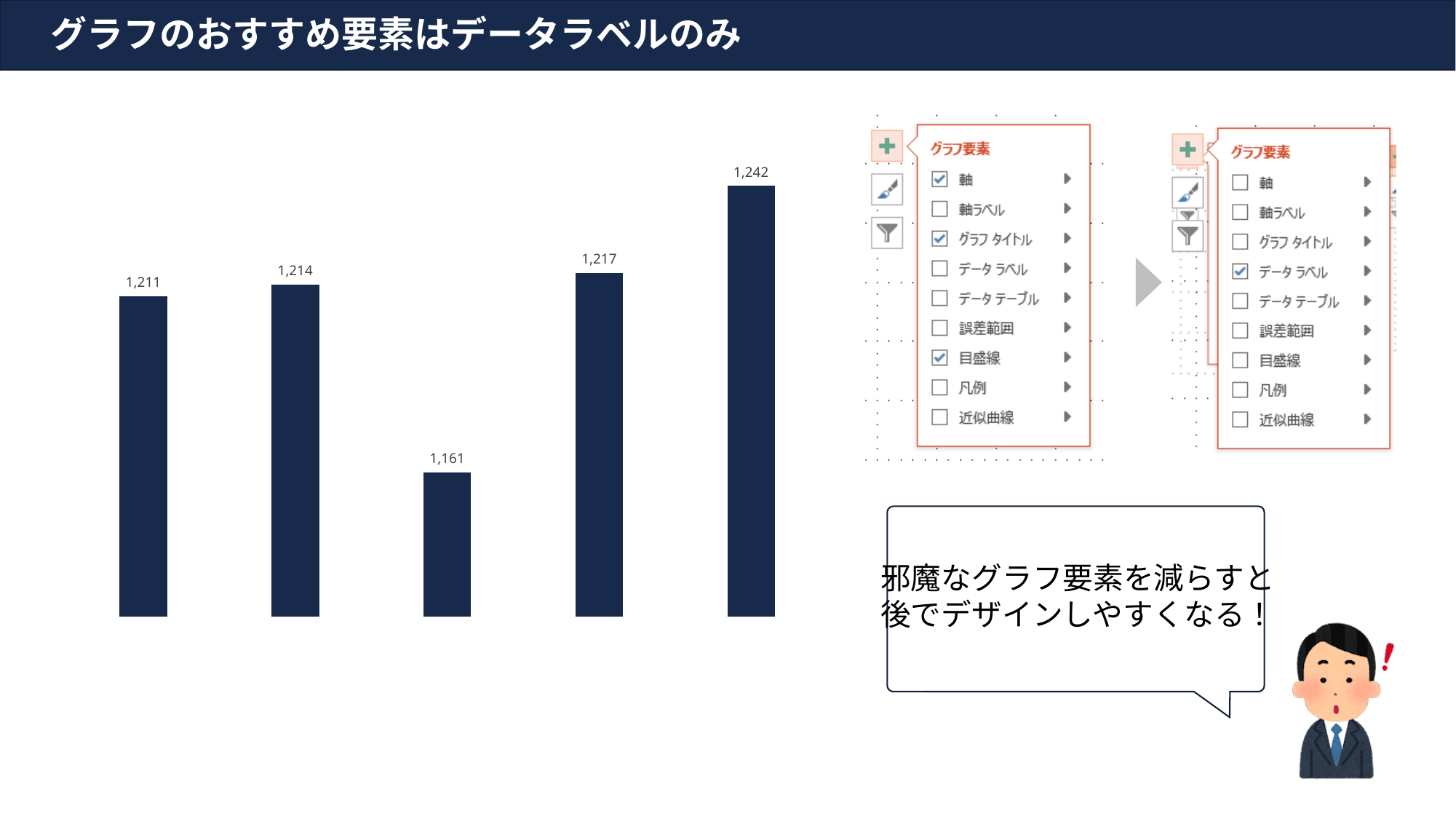
What is the difference between the highest bar (1,242) and the lowest bar (1,161)? 81 How many bars are plotted in the chart? 5 What is the value shown on the first (leftmost) bar of the chart? 1,211 What type of chart is shown on the left of the slide? Bar chart Which bar has the lowest value in the chart? The third bar, 1,161 What is the value shown on the fifth (rightmost) bar of the chart? 1,242 What is the value shown on the third bar of the chart? 1,161 What is the difference between the second bar (1,214) and the first bar (1,211)? 3 Which is larger, the value of the fourth bar or the value of the third bar? The fourth bar (1,217) What is the value shown on the fourth bar of the chart? 1,217 What colour are the bars in the chart? Dark navy blue Which bar has the highest value in the chart? The fifth (rightmost) bar, 1,242